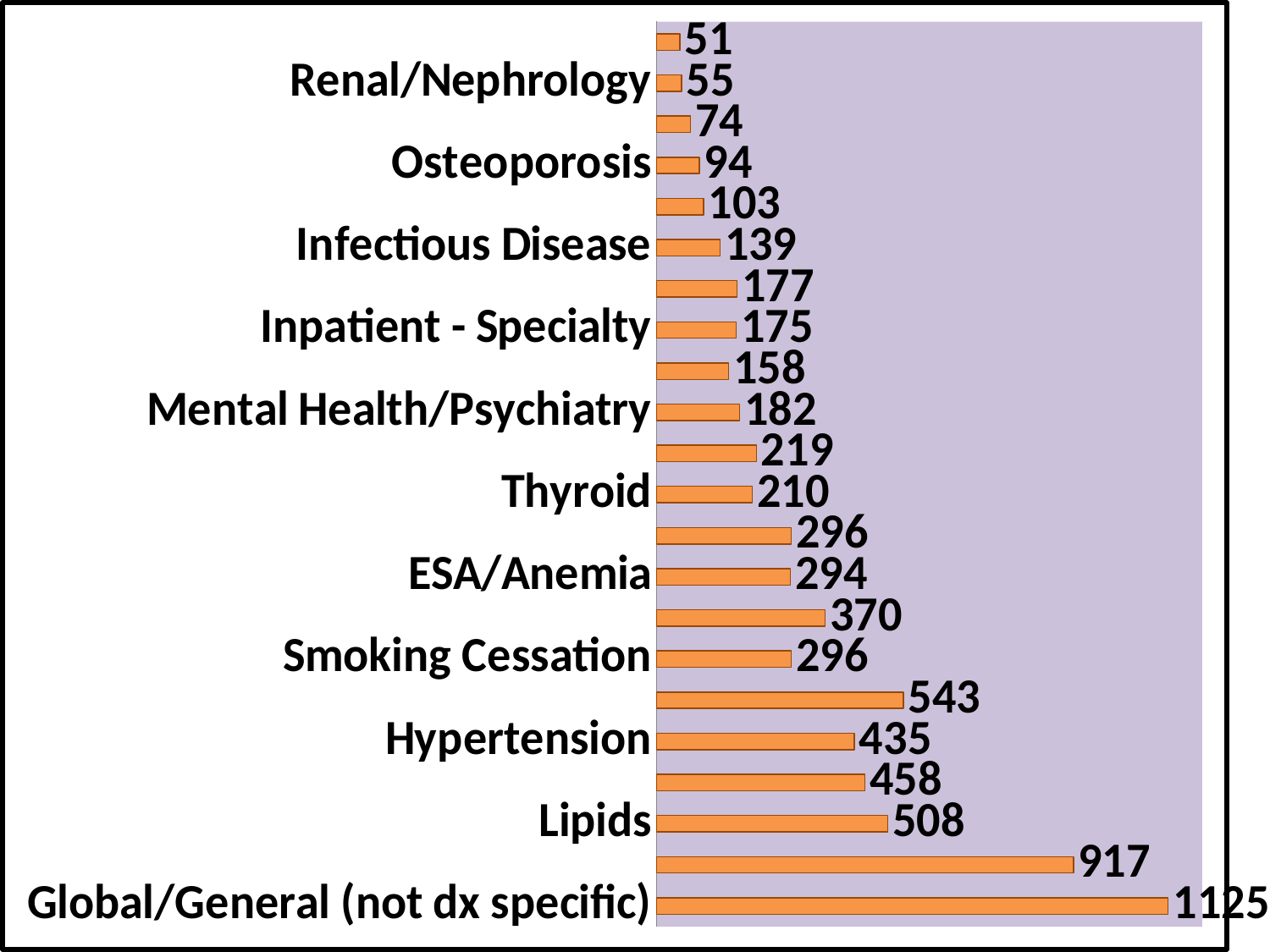
What is the value for Smoking Cessation? 296 Which is larger, the value for Infectious Disease or the value for Osteoporosis? Infectious Disease What kind of chart is shown on the slide? bar chart What is the value for Hypertension? 435 What is the value for Renal/Nephrology? 55 What is the difference between the values for Lipids and Hypertension? 73 What is the value for Global/General (not dx specific)? 1125 How many bars are plotted in the chart? 22 What is the smallest value shown on any bar in the chart? 51 What is the value for Thyroid? 210 What colour are the bars in the chart? orange Which labeled category has the highest value? Global/General (not dx specific)